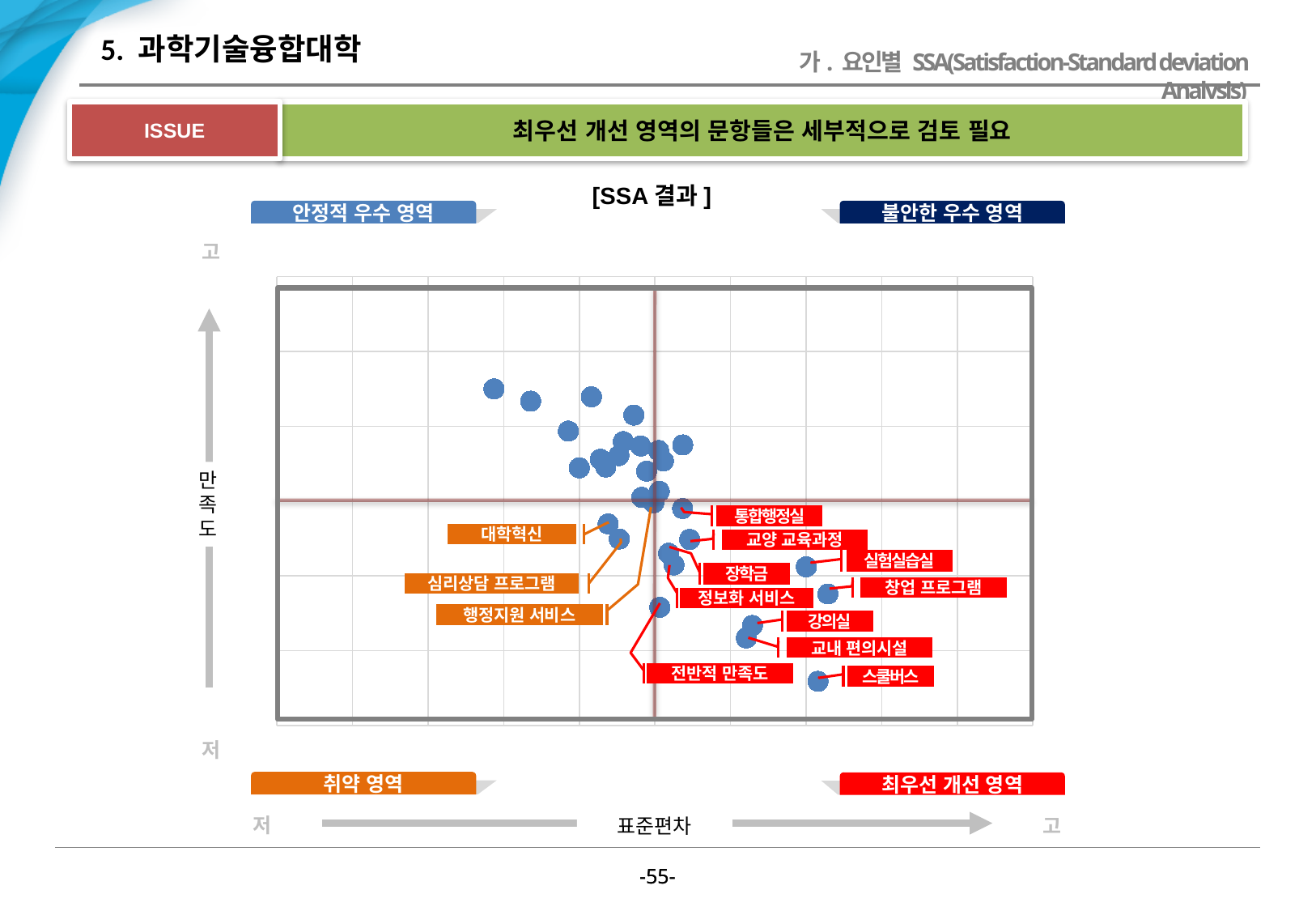
Which labelled point on the chart has the lowest satisfaction (만족도)? 스쿨버스 What is the label of the horizontal axis of the chart? 표준편차 What kind of chart is shown under the heading [SSA 결과]? scatter chart Which has a higher standard deviation (표준편차) on the chart, 창업 프로그램 or 대학혁신? 창업 프로그램 How many data points on the chart are labelled with a red label box? 10 Which has higher satisfaction (만족도) on the chart, 교양 교육과정 or 전반적 만족도? 교양 교육과정 What is the label of the vertical axis of the chart? 만족도 How many data points on the chart are labelled with an orange label box? 3 Which has a higher standard deviation (표준편차) on the chart, 심리상담 프로그램 or 강의실? 강의실